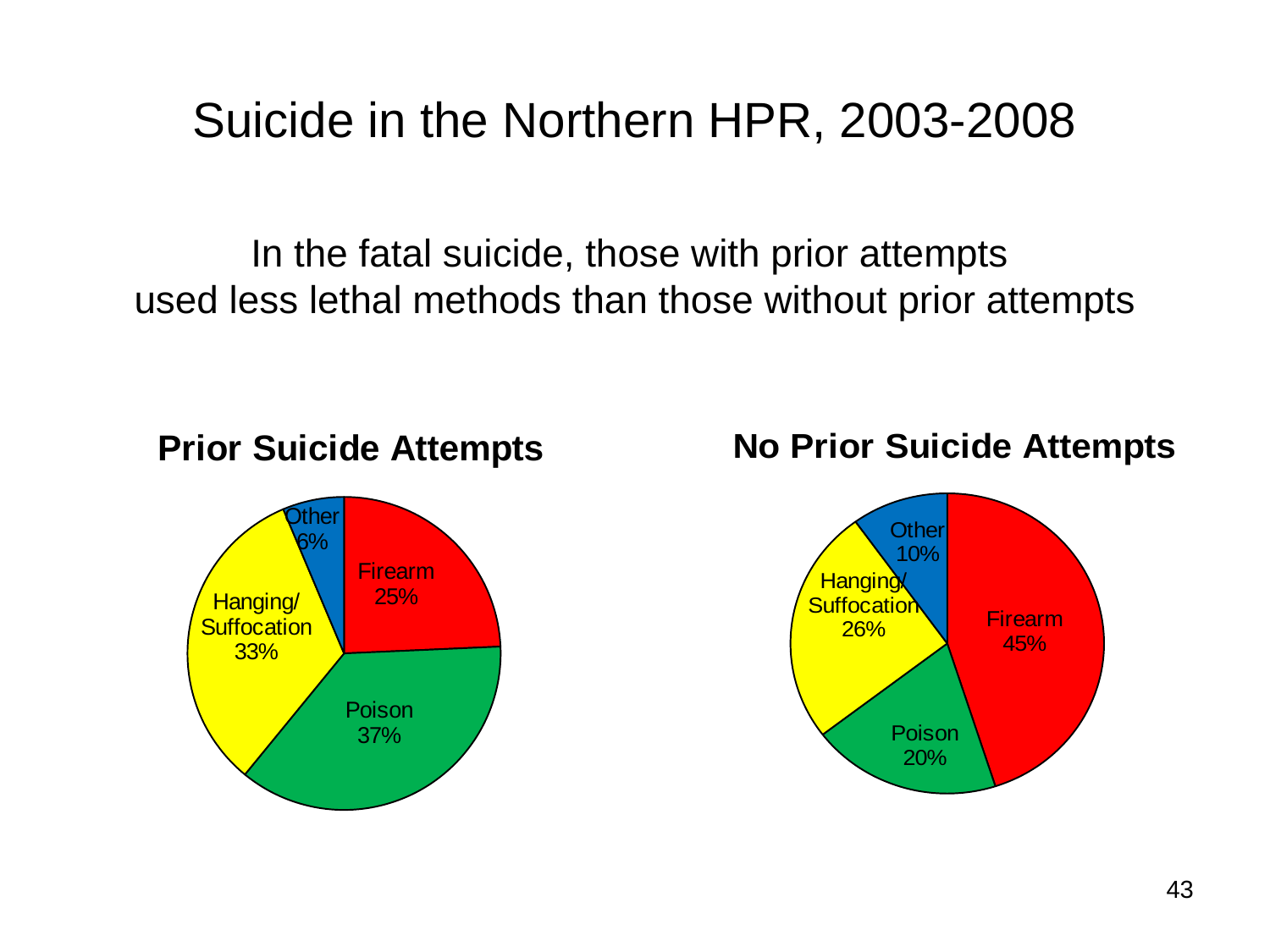
In the 'No Prior Suicide Attempts' chart, what is the difference between the Firearm and Poison shares? 25% In the 'No Prior Suicide Attempts' chart, what is the value for Other? 10% In the 'No Prior Suicide Attempts' chart, which category has the smallest slice? Other In the 'Prior Suicide Attempts' chart, what is the value for Hanging/Suffocation? 33% How many slices does the 'No Prior Suicide Attempts' chart have? 4 In the 'Prior Suicide Attempts' chart, which category has the largest slice? Poison In the 'No Prior Suicide Attempts' chart, what share of the pie is Firearm? 45% What kind of chart is the 'Prior Suicide Attempts' chart? Pie chart In the 'Prior Suicide Attempts' chart, what share of the pie is Poison? 37% In the 'Prior Suicide Attempts' chart, which is larger, Firearm or Hanging/Suffocation? Hanging/Suffocation In the 'Prior Suicide Attempts' chart, what colour is the Poison slice? Green What is the difference between the Firearm share in the 'No Prior Suicide Attempts' chart and the Firearm share in the 'Prior Suicide Attempts' chart? 20%